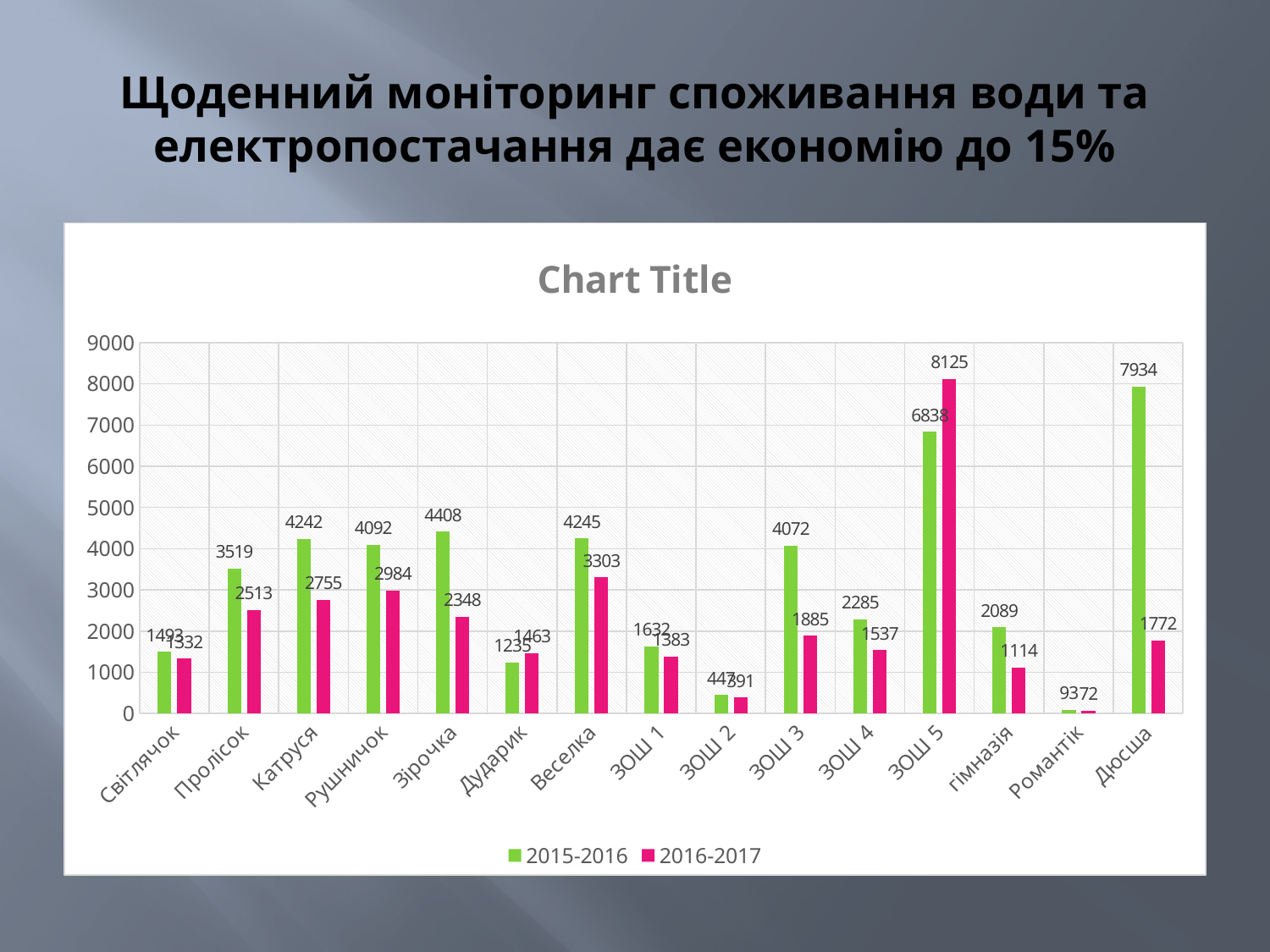
Which category has the highest value in the 2016-2017 series? ЗОШ 5 What is the difference between the 2015-2016 and 2016-2017 values for Катруся? 1487 What is the difference between the 2015-2016 and 2016-2017 values for Дюсша? 6162 What is the value for Пролісок in the 2015-2016 series? 3519 Which category has the lowest value in the 2015-2016 series? Романтік What is the value for ЗОШ 5 in the 2016-2017 series? 8125 Which category has the highest value in the 2015-2016 series? Дюсша For Дударик, which series has the larger value, 2015-2016 or 2016-2017? 2016-2017 Is the 2016-2017 value for Зірочка greater or less than 3000? less How many series does the legend list? 2 What is the value for Веселка in the 2016-2017 series? 3303 How many categories are shown on the x axis? 15